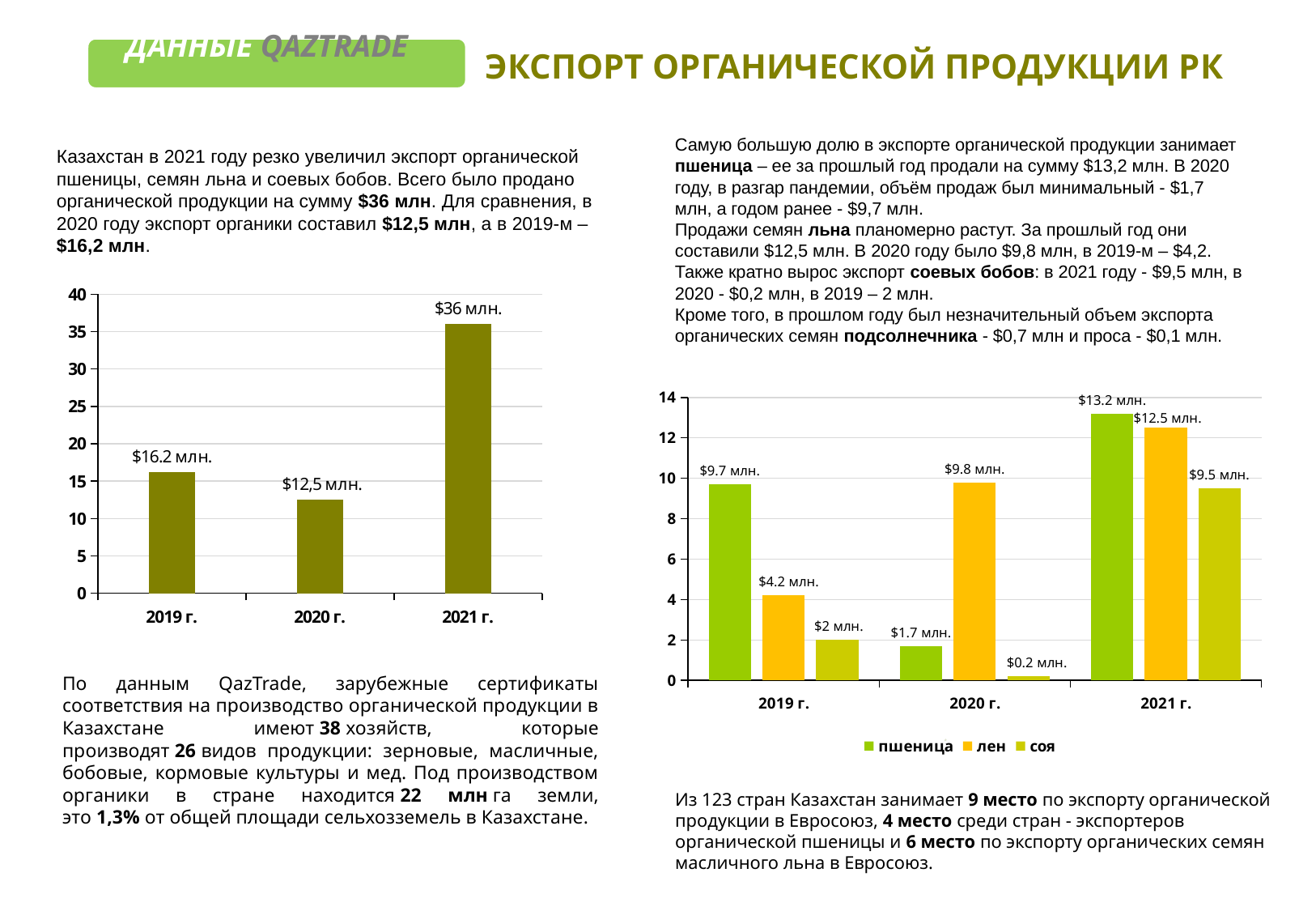
What kind of chart is the left chart? bar chart On the right chart, which series has the lowest value in 2020 г.? соя On the left chart, which year has the lowest value? 2020 г. On the left chart, how many bars are plotted? 3 On the left chart, what is the value for 2021 г.? $36 млн. On the right chart, what is the value for соя in 2021 г.? $9.5 млн. On the left chart, what is the difference between the values for 2021 г. and 2019 г.? $19.8 млн. On the right chart, what is the value for лен in 2020 г.? $9.8 млн. On the right chart, do the values for лен rise or fall from 2019 г. to 2021 г.? rise On the left chart, what is the value for 2020 г.? $12,5 млн. On the right chart, is the value for пшеница in 2019 г. larger or smaller than the value for лен in 2019 г.? larger On the right chart, how many series does the legend list? 3